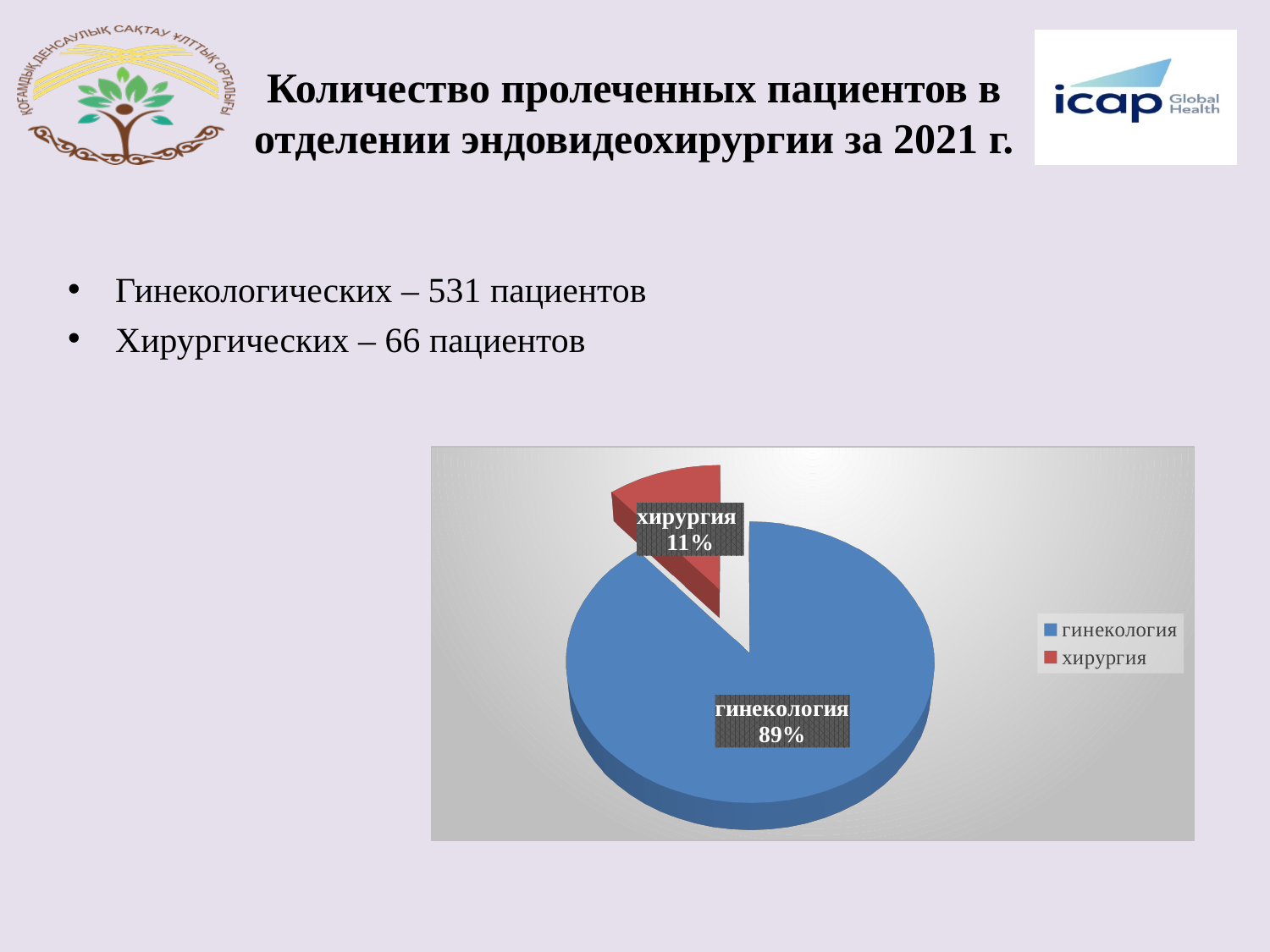
What share of the pie does хирургия represent? 11% How many slices does the pie chart have? 2 What colour is the хирургия slice? red What is the difference in percentage points between the гинекология and хирургия shares? 78 Which slice of the pie is the smallest? хирургия How many entries does the legend list? 2 What share of the pie does гинекология represent? 89% Which slice of the pie is the largest? гинекология Is the share for хирургия greater or less than 50%? less What kind of chart is shown on the slide? pie chart What colour is the гинекология slice? blue Which is larger, the share for гинекология or the share for хирургия? гинекология